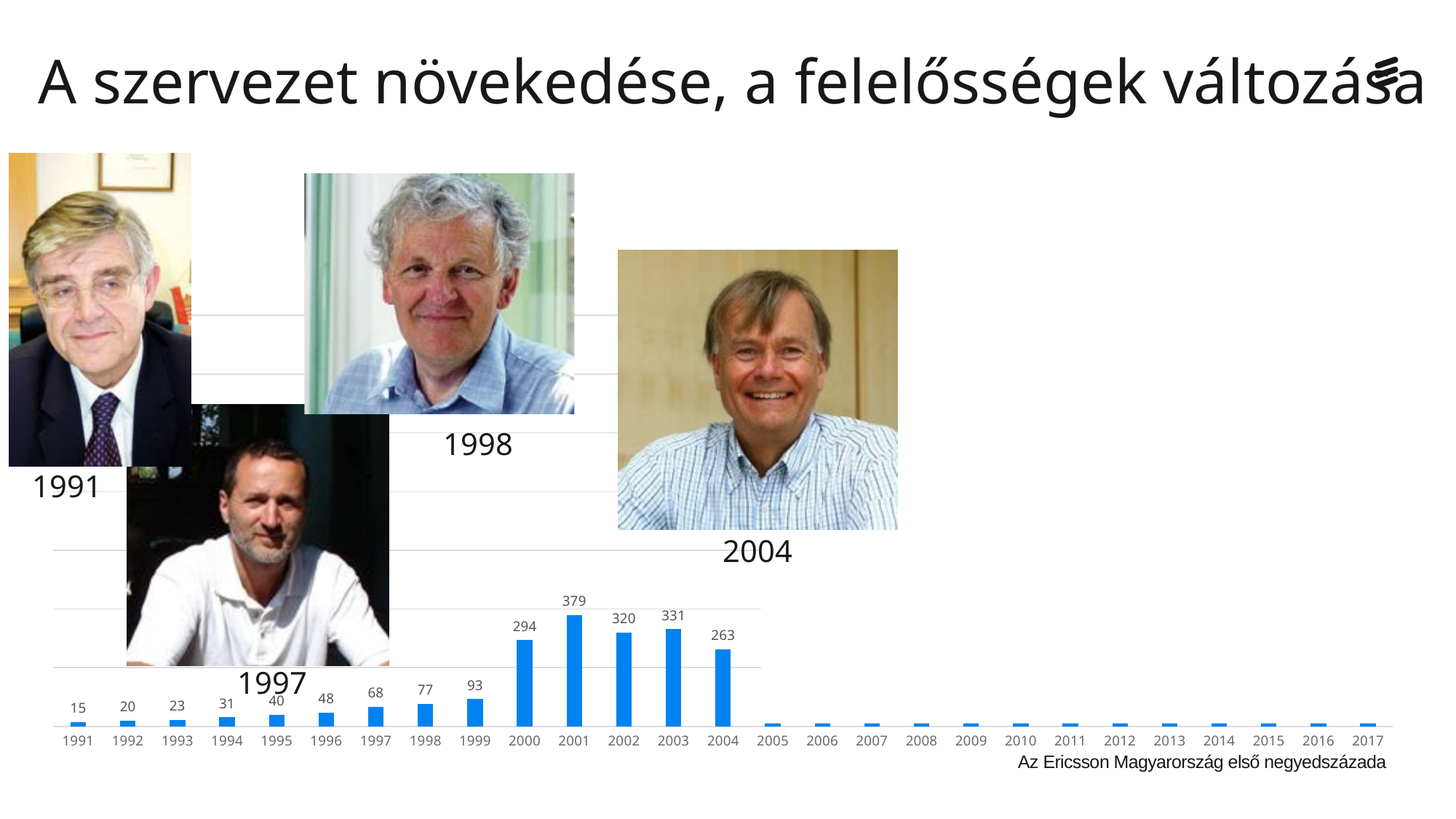
What is the difference between the values for 2001 and 2000? 85 What is the value shown for 2004? 263 Which is larger, the value for 1999 or the value for 1998? 1999 What is the value shown for 1991? 15 What kind of chart is shown on the slide? bar chart What is the difference between the values for 2003 and 2002? 11 Which is larger, the value for 2002 or the value for 2004? 2002 Which year has the highest value on the chart? 2001 What is the value shown for 2001? 379 What is the value shown for 1997? 68 How many years are shown on the x axis of the chart? 27 Do the values rise or fall from 1991 to 2001? rise